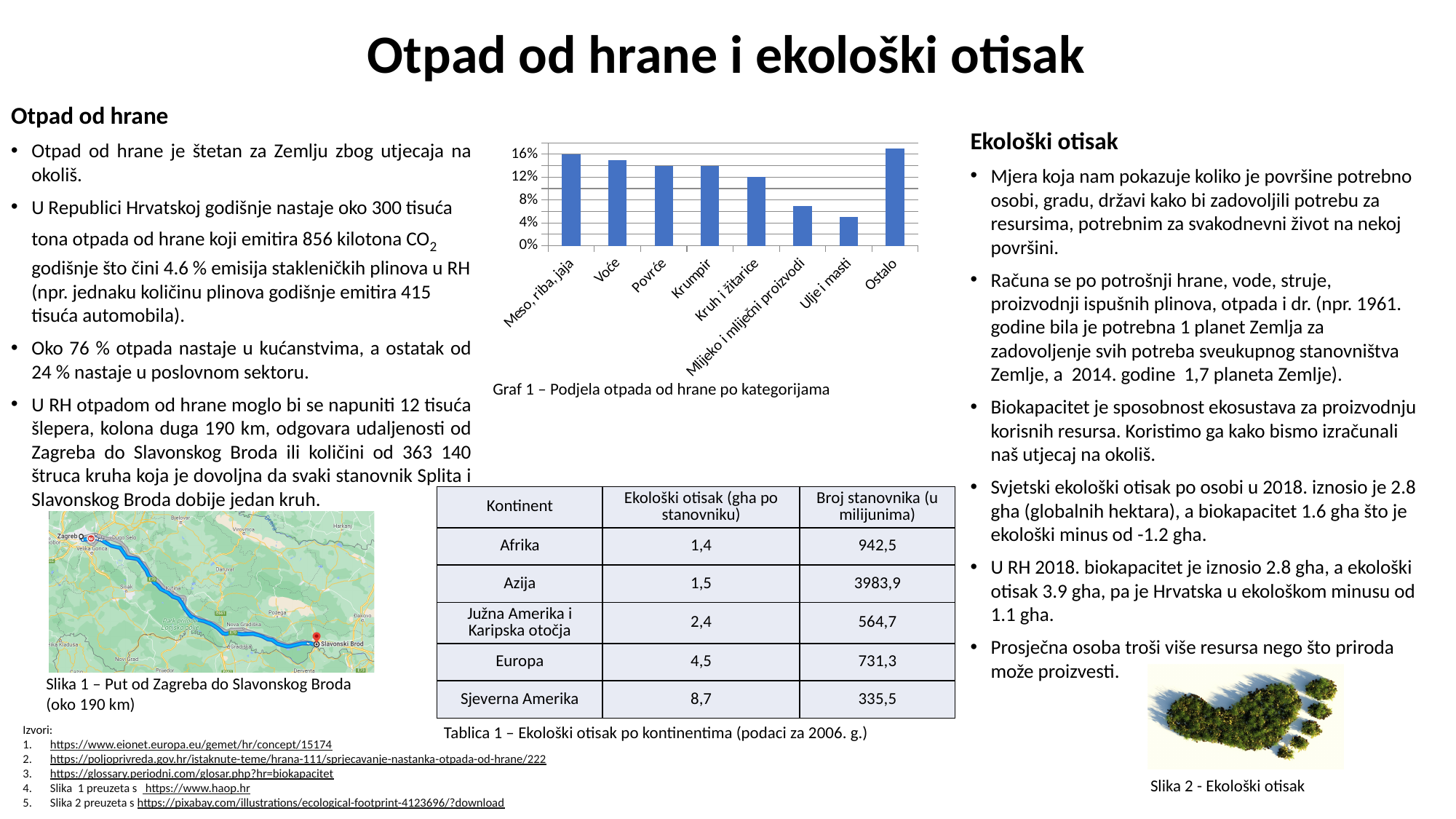
In Graf 1, is the value for Kruh i žitarice greater or less than 16%? less In Graf 1, is the value for Mlijeko i mliječni proizvodi greater or less than 8%? less Which category has the lowest bar in Graf 1? Ulje i masti What kind of chart is Graf 1 on the slide? bar chart Which category has the highest bar in Graf 1? Ostalo In Graf 1, is the value for Ostalo greater or less than 16%? greater How many categories are shown in the bar chart (Graf 1)? 8 In Graf 1, which is larger: the value for Meso, riba, jaja or the value for Ulje i masti? Meso, riba, jaja What is the caption of the bar chart on the slide? Graf 1 – Podjela otpada od hrane po kategorijama In Graf 1, which is larger: the value for Voće or the value for Mlijeko i mliječni proizvodi? Voće